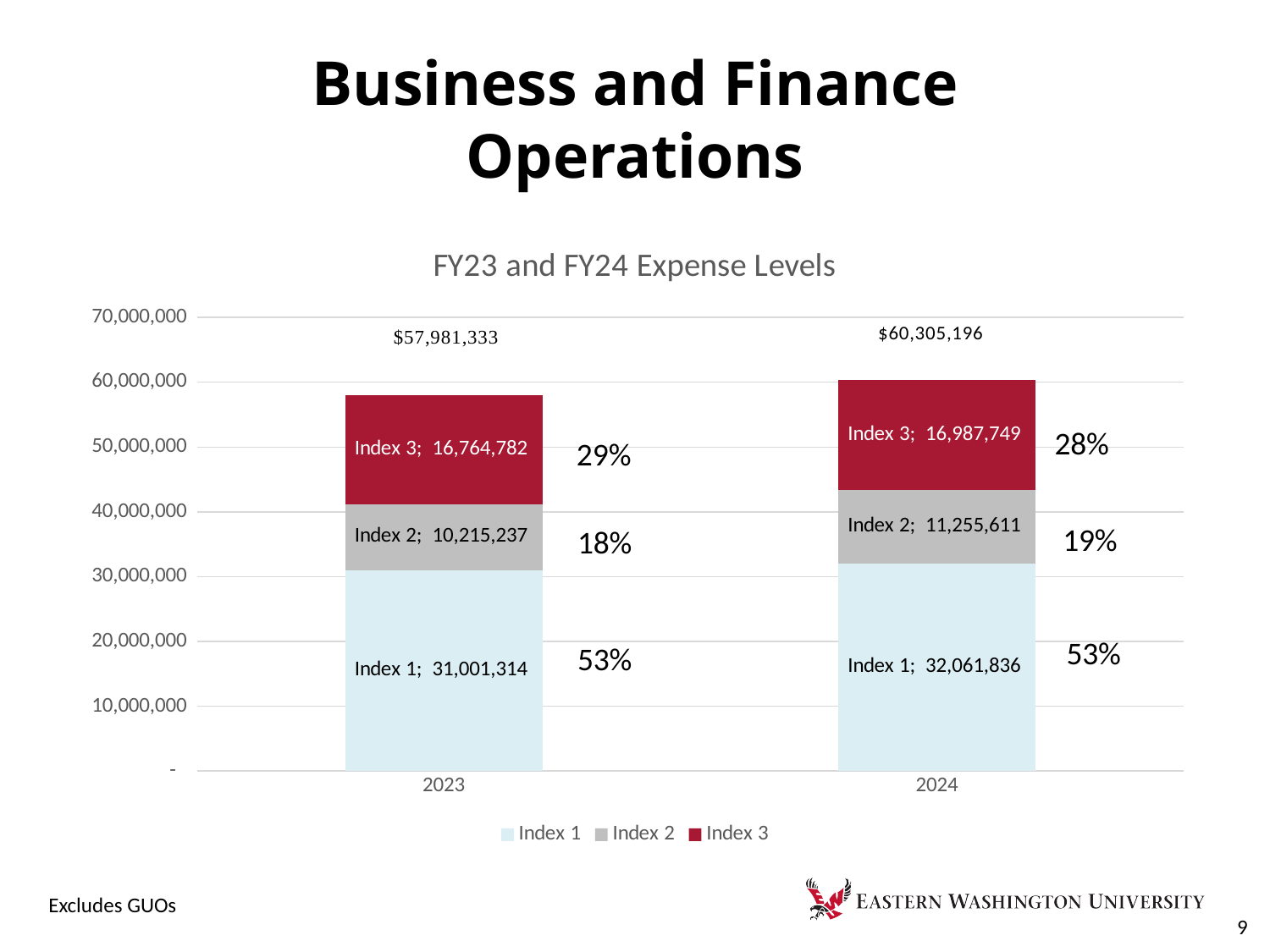
What is the total of the stacked bar for 2024? $60,305,196 What is the total of the stacked bar for 2023? $57,981,333 What is the title of the chart? FY23 and FY24 Expense Levels What kind of chart is shown on the slide? Stacked bar chart How many series does the legend list? 3 What is the difference between the Index 3 values for 2024 and 2023? 222,967 What is the value of Index 1 for 2023? 31,001,314 What is the value of Index 2 for 2024? 11,255,611 What share of the 2023 total does Index 3 represent, as labelled on the chart? 29% What is the value of Index 3 for 2023? 16,764,782 What is the difference between the Index 2 values for 2024 and 2023? 1,040,374 Which year has the larger Index 1 value, 2023 or 2024? 2024